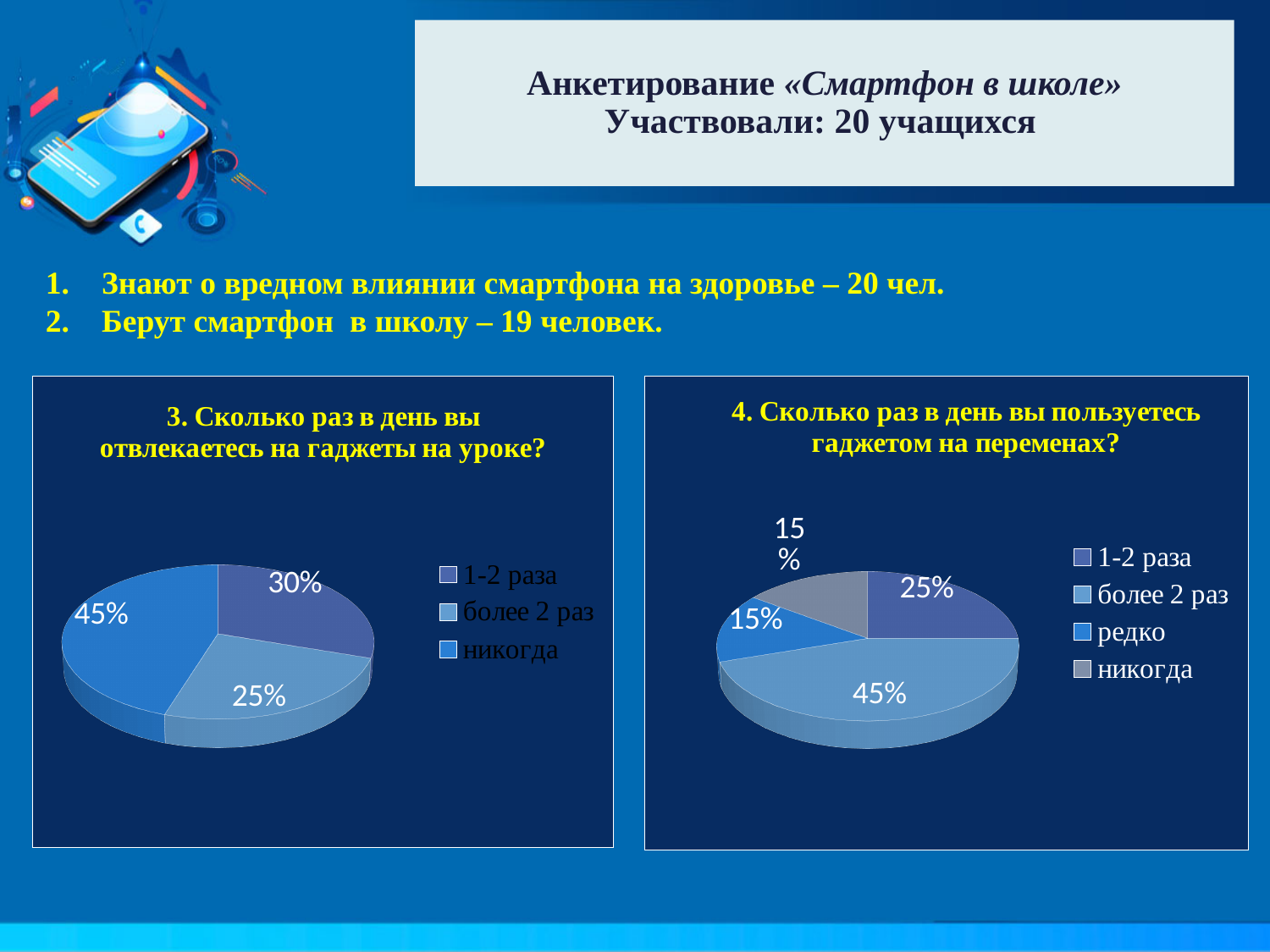
How many categories does the legend of the right chart (question 4) list? 4 On the left chart (question 3), what is the difference in percentage points between "никогда" and "более 2 раз"? 20 On the right chart (question 4), which is larger: the share for "1-2 раза" or the share for "никогда"? 1-2 раза What type of chart is used for question 3 on the left? Pie chart On the right chart (question 4), what percentage of students answered "редко"? 15% On the right chart (question 4), which answer has the largest share? более 2 раз On the left chart (question 3), which answer has the smallest share? более 2 раз On the left chart (question 3), which answer has the largest share? никогда On the left chart (question 3), what percentage of students answered "1-2 раза"? 30% On the right chart (question 4), what percentage of students answered "более 2 раз"? 45% On the left chart (question 3), what percentage of students answered "никогда"? 45% How many slices does the left chart (question 3) have? 3